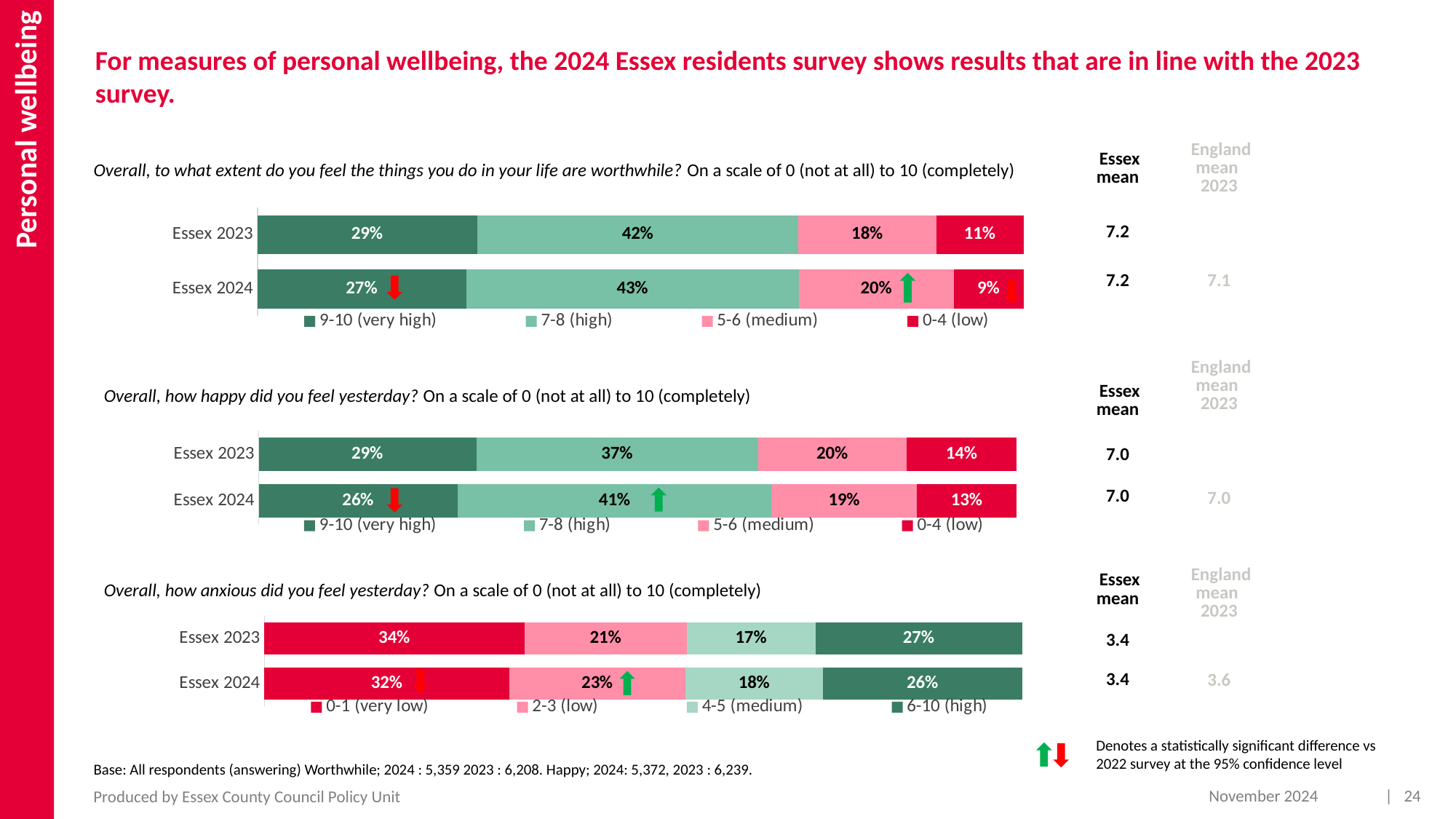
In the 'anxious' chart, what percentage of Essex 2023 respondents gave a 0-1 (very low) rating? 34% In the 'worthwhile' chart, what is the difference between the 9-10 (very high) share for Essex 2023 and Essex 2024? 2 percentage points In the 'worthwhile' chart, what percentage of Essex 2024 respondents gave a 7-8 (high) rating? 43% How many bars (categories) are shown in the 'happy' chart? 2 How many series does the legend of the 'anxious' chart list? 4 In the 'worthwhile' chart, what percentage of Essex 2023 respondents gave a 0-4 (low) rating? 11% In the 'anxious' chart, what is the difference between the 2-3 (low) share for Essex 2024 and Essex 2023? 2 percentage points In the 'happy' chart, what percentage of Essex 2024 respondents gave a 9-10 (very high) rating? 26% In the 'happy' chart, which rating band has the largest share for Essex 2023? 7-8 (high) In the 'happy' chart, which rating band has the smallest share for Essex 2024? 0-4 (low) What type of chart is used for the 'worthwhile' question? Stacked bar chart In the 'happy' chart, is the 7-8 (high) share larger for Essex 2023 or Essex 2024? Essex 2024